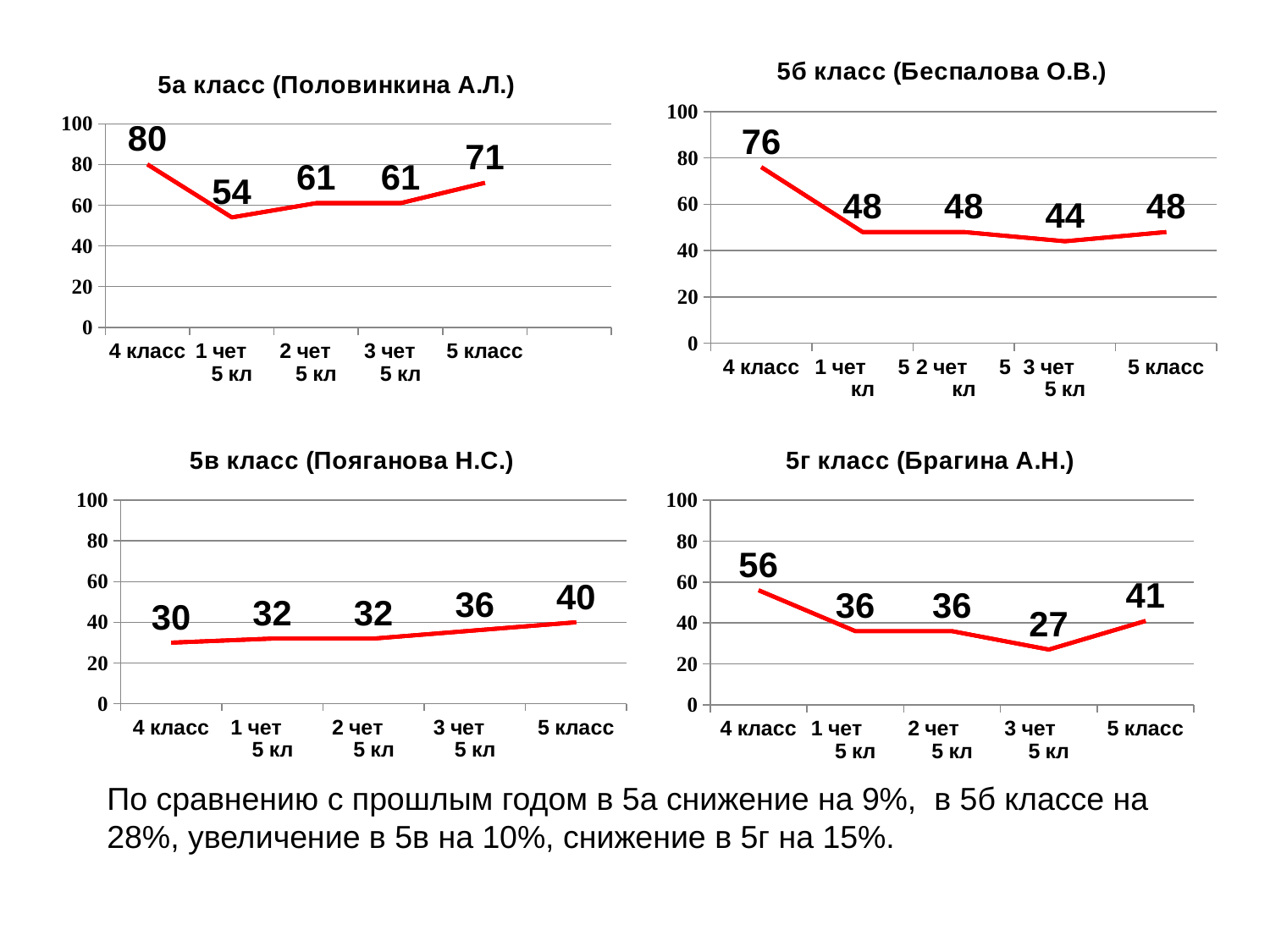
In the chart titled "5б класс (Беспалова О.В.)", what is the difference between the values for "4 класс" and "5 класс"? 28 How many charts are shown on the slide? 4 How many data points are plotted in the chart titled "5а класс (Половинкина А.Л.)"? 5 In the chart titled "5а класс (Половинкина А.Л.)", which category has the highest value? 4 класс In the chart titled "5в класс (Пояганова Н.С.)", do the values generally rise or fall from "4 класс" to "5 класс"? rise In the chart titled "5г класс (Брагина А.Н.)", which category has the lowest value? 3 чет 5 кл In the chart titled "5в класс (Пояганова Н.С.)", what is the value for "5 класс"? 40 In the chart titled "5в класс (Пояганова Н.С.)", what is the difference between the values for "5 класс" and "4 класс"? 10 In the chart titled "5г класс (Брагина А.Н.)", which is larger: the value for "4 класс" or the value for "5 класс"? 4 класс In the chart titled "5а класс (Половинкина А.Л.)", what is the value for "4 класс"? 80 What kind of chart is the one titled "5г класс (Брагина А.Н.)"? line chart In the chart titled "5б класс (Беспалова О.В.)", what is the value for "3 чет 5 кл"? 44